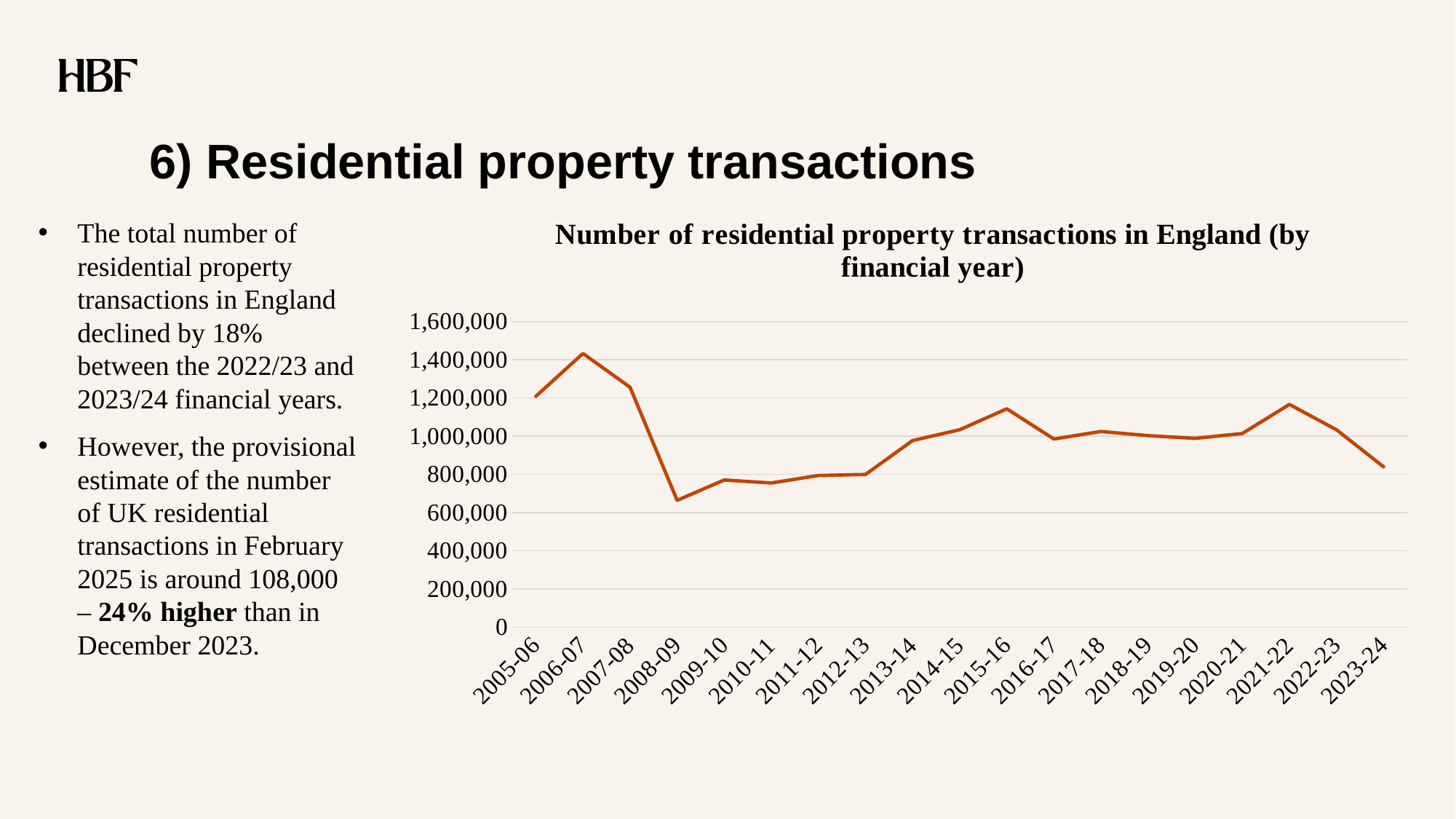
Which financial year has the lowest number of residential property transactions? 2008-09 What kind of chart is shown on the slide? line chart How many financial years are plotted on the x axis of the chart? 19 Which is larger, the value for 2006-07 or the value for 2021-22? 2006-07 Is the value for 2008-09 greater or less than 800,000? less Is the value for 2023-24 greater or less than 1,000,000? less Which financial year has the highest number of residential property transactions? 2006-07 Is the value for 2005-06 greater or less than 1,000,000? greater Which is larger, the value for 2008-09 or the value for 2023-24? 2023-24 Do the values rise or fall from 2021-22 to 2023-24? fall What is the title of the chart? Number of residential property transactions in England (by financial year)